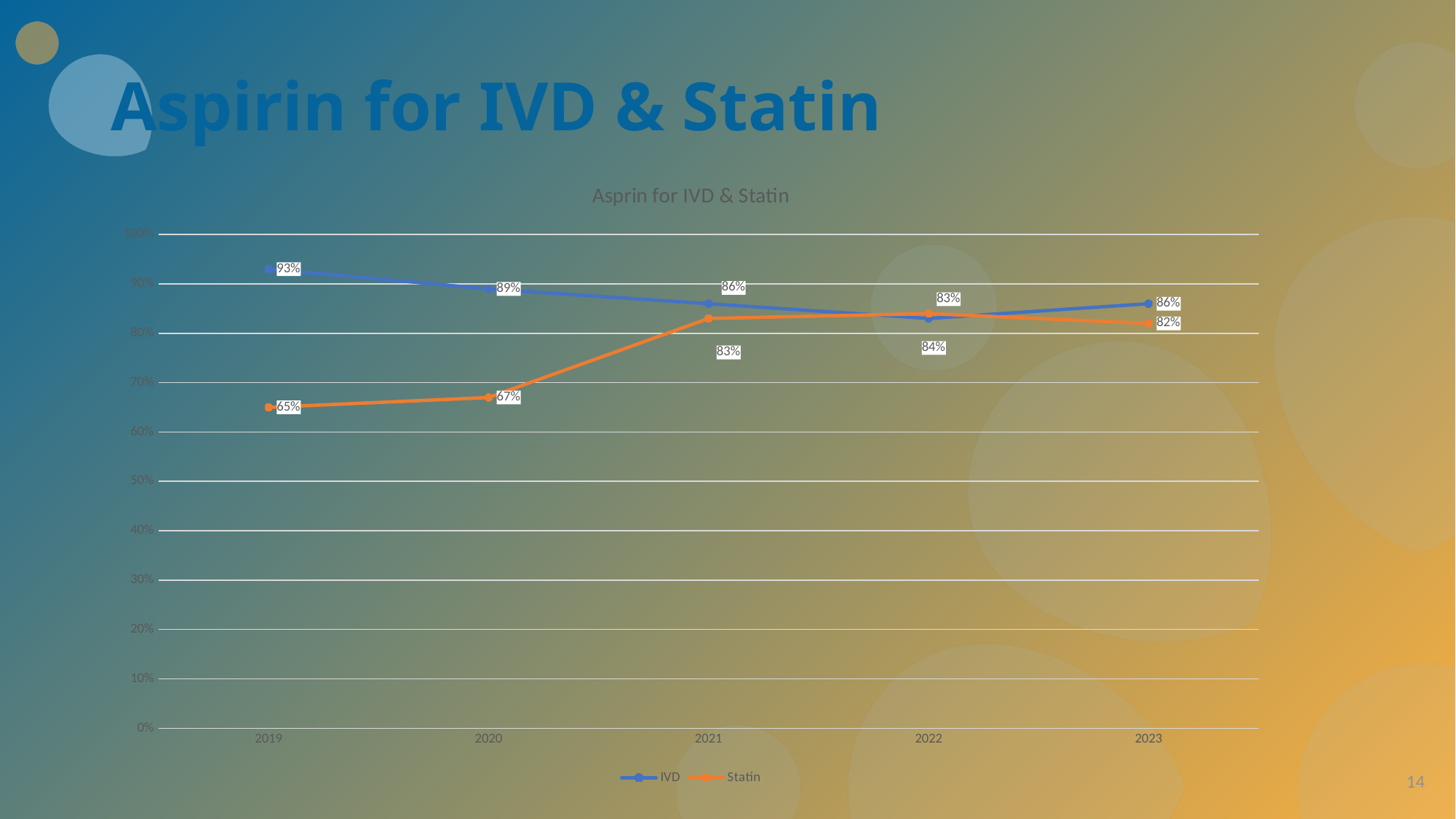
How many series does the legend list? 2 Which is larger in 2023, the IVD value or the Statin value? IVD What is the Statin value for 2023? 82% What type of chart is shown on the slide? Line chart In which year is the IVD value highest? 2019 What is the difference between the IVD and Statin values in 2019? 28% In which year is the Statin value lowest? 2019 What is the IVD value for 2019? 93% How many years are shown on the x axis? 5 Does the Statin line generally rise or fall from 2019 to 2022? Rise What is the IVD value for 2021? 86% What is the Statin value for 2020? 67%